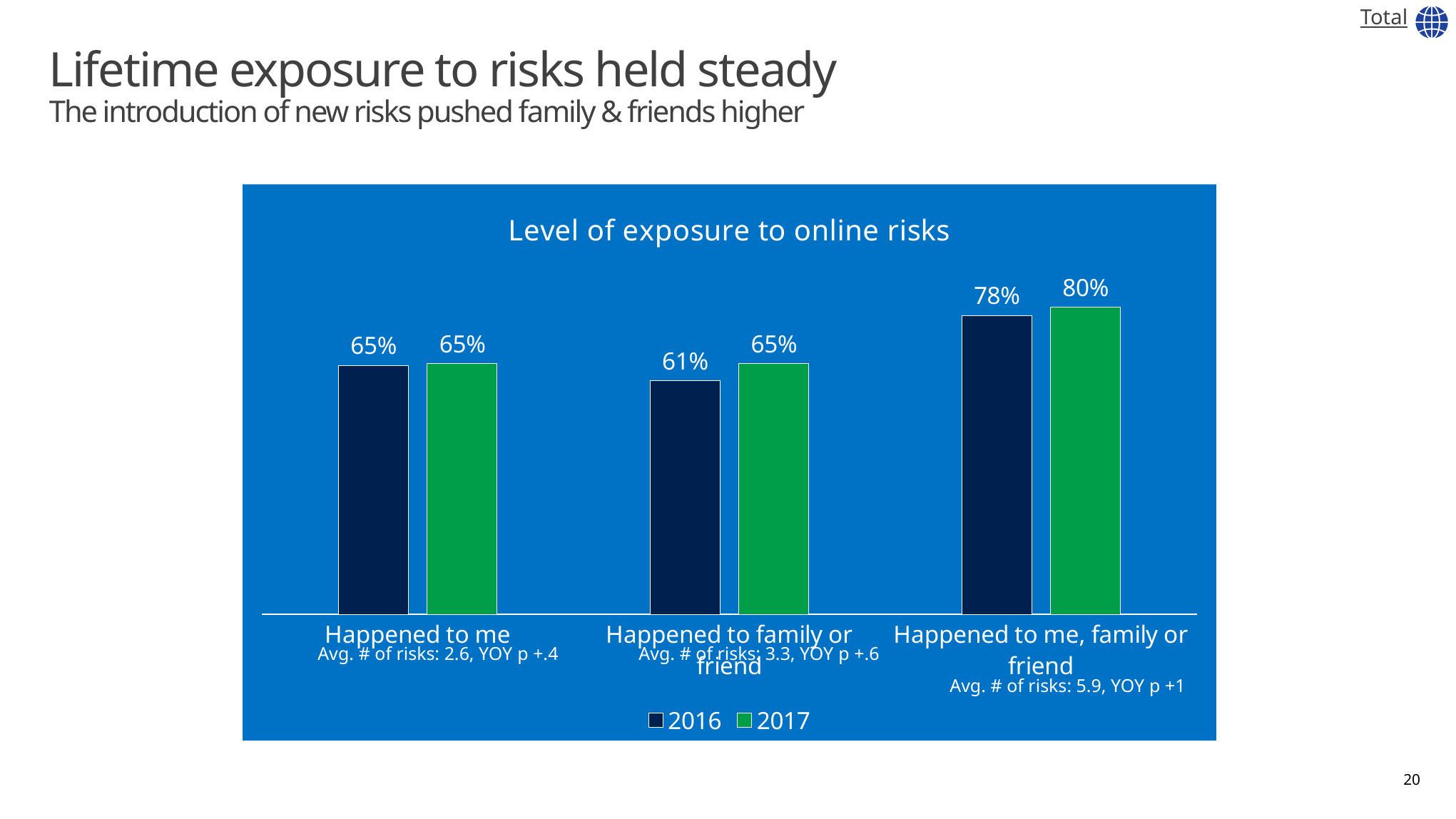
What is the difference between the 2017 and 2016 values for "Happened to family or friend"? 4% What type of chart is shown? Bar chart Which category has the lowest 2016 value? Happened to family or friend What is the 2017 value for "Happened to family or friend"? 65% What is the 2016 value for "Happened to me"? 65% What is the difference between the 2017 and 2016 values for "Happened to me, family or friend"? 2% What is the 2017 value for "Happened to me, family or friend"? 80% What is the 2016 value for "Happened to me, family or friend"? 78% How many series does the legend list? 2 How many categories are shown on the x axis? 3 Which is larger for "Happened to family or friend": the 2016 value or the 2017 value? 2017 Which category has the highest 2017 value? Happened to me, family or friend